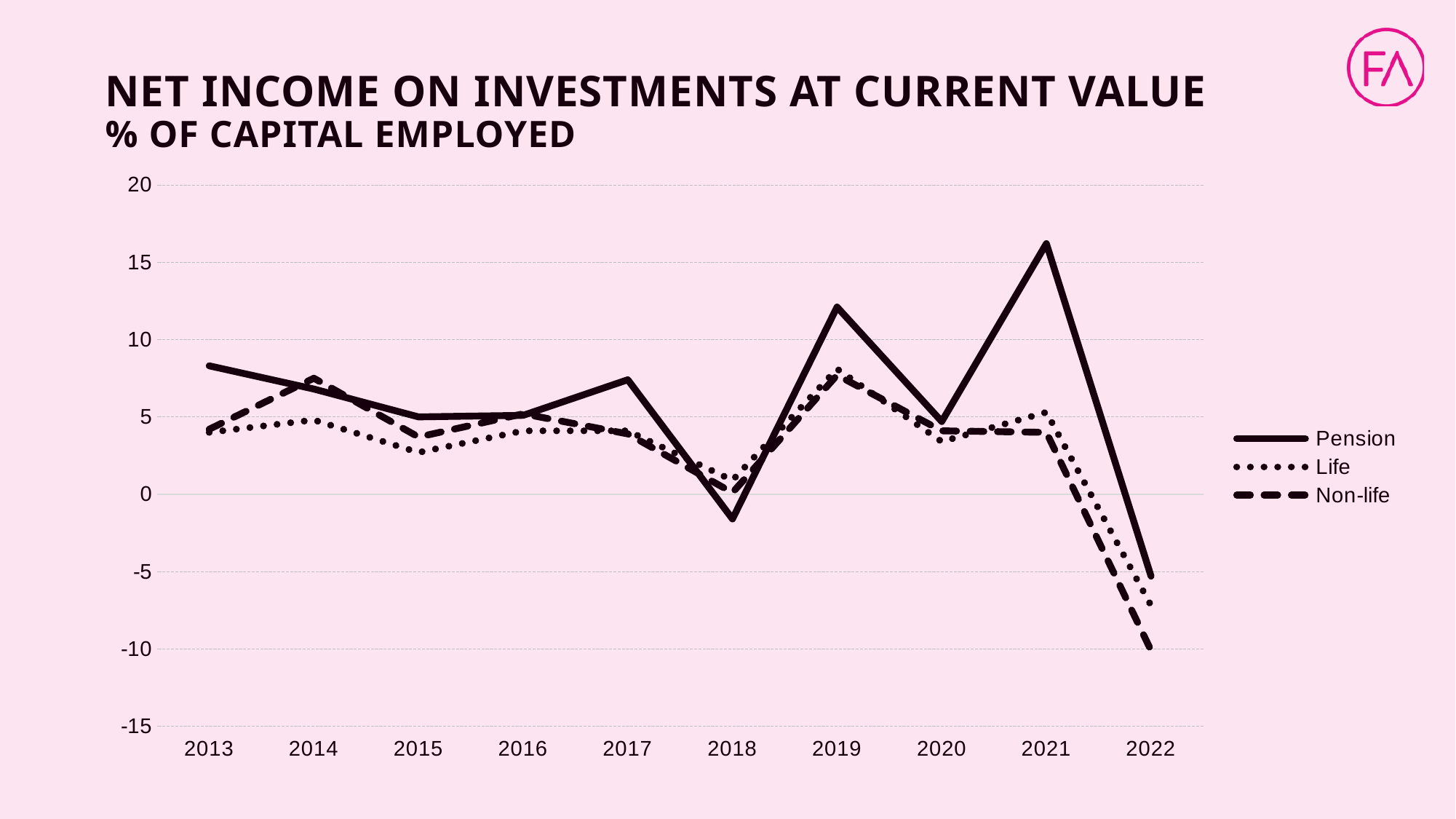
In which year does the Non-life series reach its lowest value? 2022 Which series is drawn with a dotted line in the legend? Life In which year does the Pension series reach its highest value? 2021 In 2019, which series has the larger value, Pension or Life? Pension In 2022, which series has the larger value, Pension or Non-life? Pension Is the value for Pension in 2021 greater or less than 15? greater Is the value for Non-life in 2022 greater or less than -5? less What kind of chart is shown on the slide? Line chart Is the value for Pension in 2019 greater or less than 10? greater How many years are shown on the x axis? 10 How many series does the legend list? 3 Does the Pension series rise or fall from 2021 to 2022? Fall